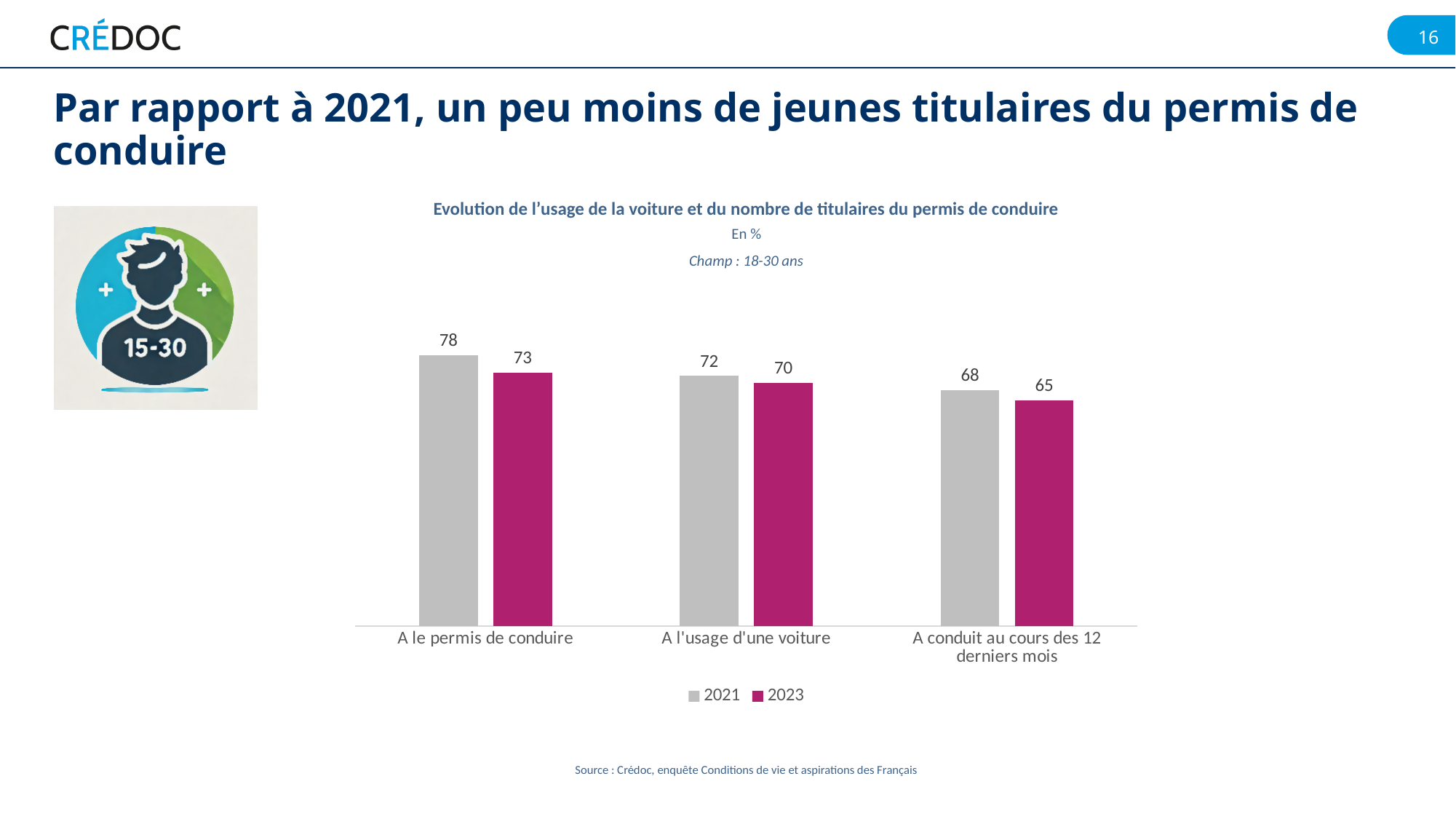
Which category has the lowest 2023 value? A conduit au cours des 12 derniers mois What is the difference between the 2021 and 2023 values for "A conduit au cours des 12 derniers mois"? 3 Which is larger: the 2021 value for "A l'usage d'une voiture" or the 2023 value for "A le permis de conduire"? 2023 value for "A le permis de conduire" What is the title of the chart? Evolution de l'usage de la voiture et du nombre de titulaires du permis de conduire How many series does the legend list? 2 How many categories are shown on the x axis? 3 What kind of chart is shown? Bar chart Which category has the highest 2021 value? A le permis de conduire What is the 2021 value for "A le permis de conduire"? 78 What is the difference between the 2021 and 2023 values for "A le permis de conduire"? 5 What is the 2023 value for "A l'usage d'une voiture"? 70 What is the 2023 value for "A conduit au cours des 12 derniers mois"? 65